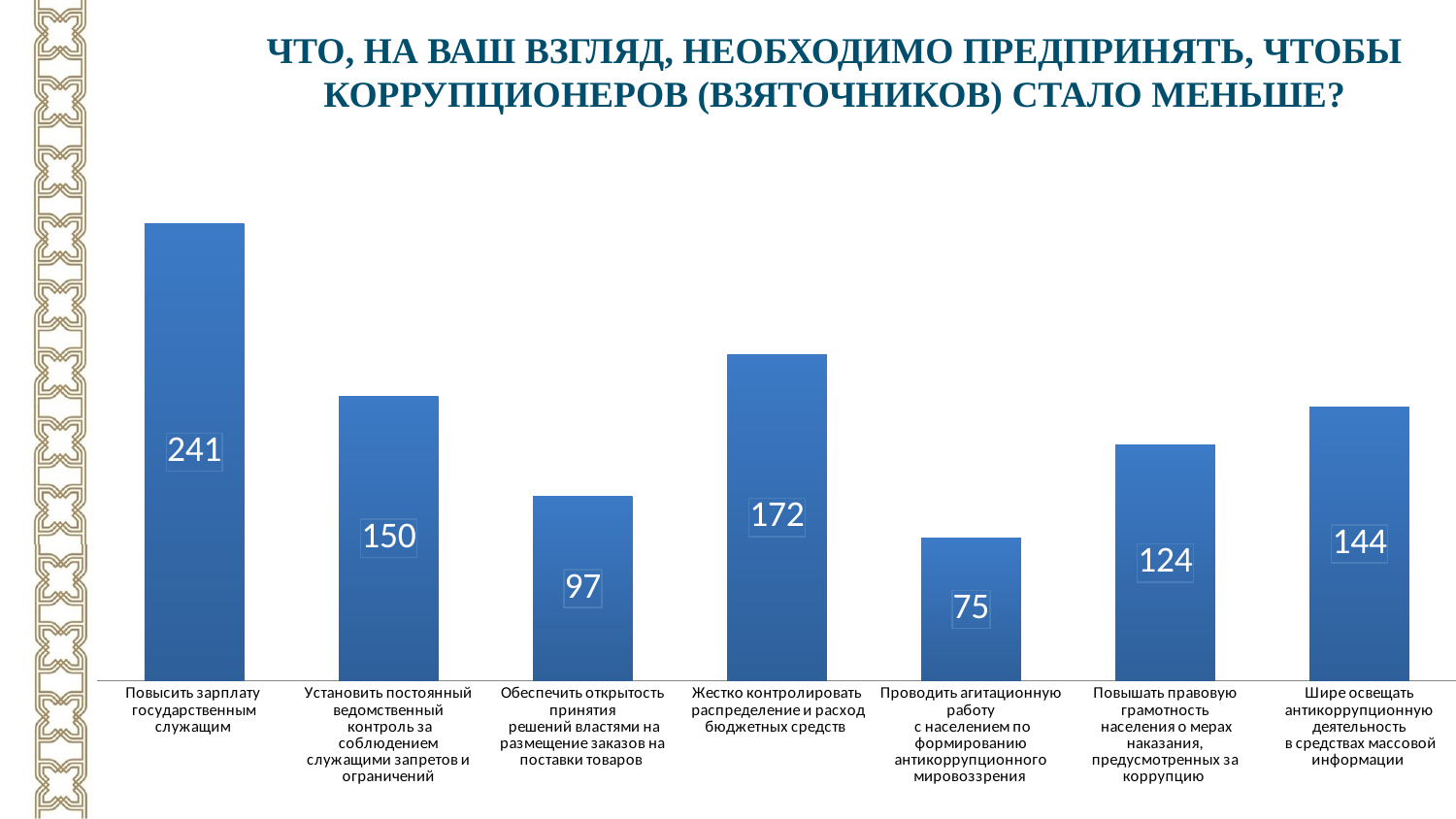
Which category has the lowest value? Проводить агитационную работу с населением по формированию антикоррупционного мировоззрения What kind of chart is shown on the slide? Bar chart What is the value for "Жестко контролировать распределение и расход бюджетных средств"? 172 Which category has the highest value? Повысить зарплату государственным служащим Which is larger: the value for "Установить постоянный ведомственный контроль за соблюдением служащими запретов и ограничений" or for "Шире освещать антикоррупционную деятельность в средствах массовой информации"? Установить постоянный ведомственный контроль за соблюдением служащими запретов и ограничений What is the value for "Шире освещать антикоррупционную деятельность в средствах массовой информации"? 144 What is the difference between the values for "Жестко контролировать распределение и расход бюджетных средств" and "Повышать правовую грамотность населения о мерах наказания, предусмотренных за коррупцию"? 48 What is the value for "Обеспечить открытость принятия решений властями на размещение заказов на поставки товаров"? 97 What is the value for "Повысить зарплату государственным служащим"? 241 How many categories are shown in the chart? 7 What is the title of the slide? ЧТО, НА ВАШ ВЗГЛЯД, НЕОБХОДИМО ПРЕДПРИНЯТЬ, ЧТОБЫ КОРРУПЦИОНЕРОВ (ВЗЯТОЧНИКОВ) СТАЛО МЕНЬШЕ? What is the difference between the values for "Повысить зарплату государственным служащим" and "Установить постоянный ведомственный контроль за соблюдением служащими запретов и ограничений"? 91